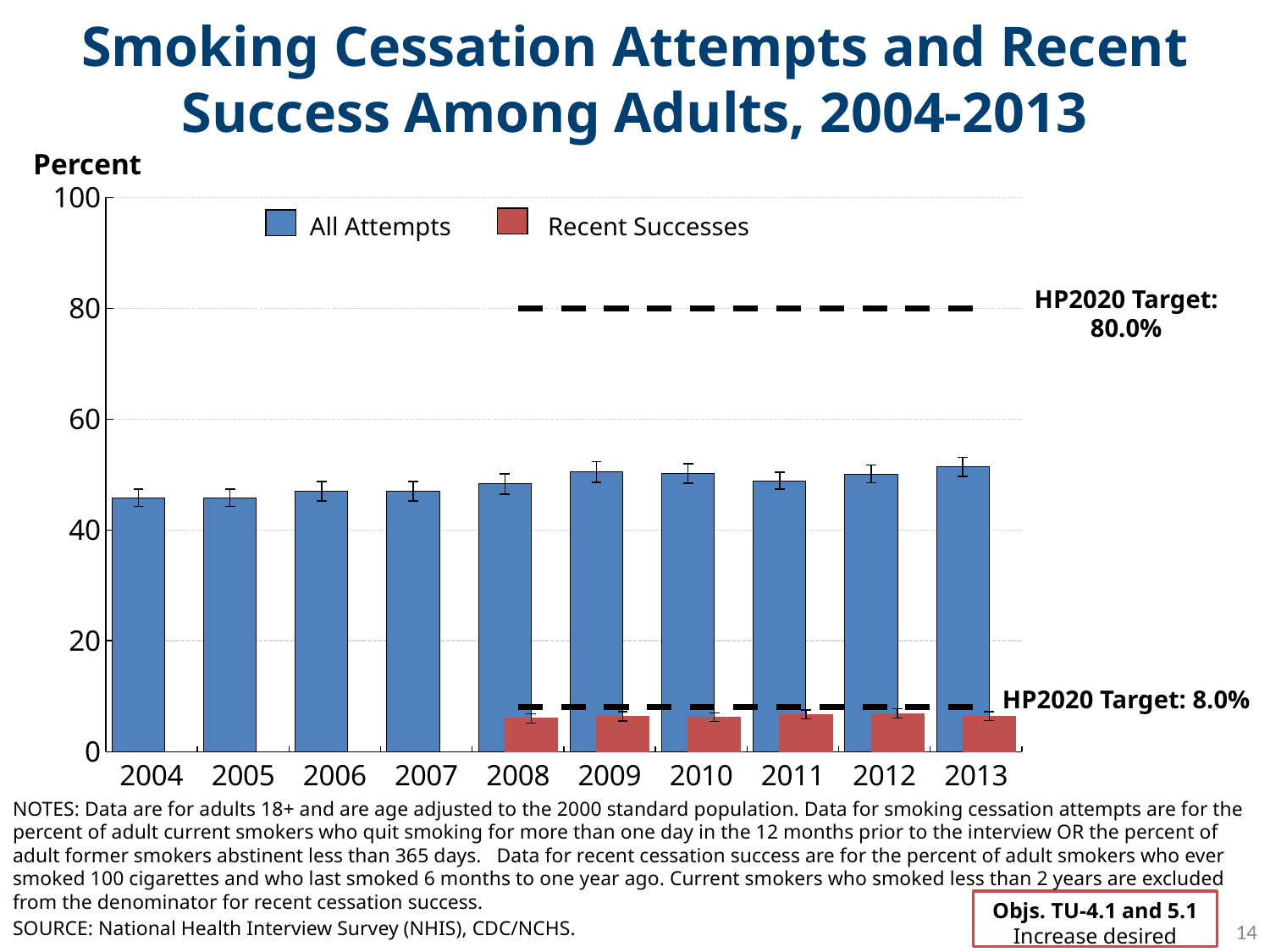
Is the All Attempts value for 2013 greater or less than 40? greater Which is larger, the All Attempts value for 2013 or for 2004? 2013 What is the HP2020 Target shown for Recent Successes? 8.0% Do the All Attempts values generally rise or fall from 2004 to 2013? rise Is the All Attempts value for 2004 greater or less than 60? less Which series has the higher values, All Attempts or Recent Successes? All Attempts For how many years are Recent Successes bars plotted? 6 What kind of chart is shown on the slide? bar chart How many years are shown on the x axis? 10 Is the Recent Successes value for 2010 greater or less than 20? less What is the HP2020 Target shown for All Attempts? 80.0% How many series does the legend list? 2